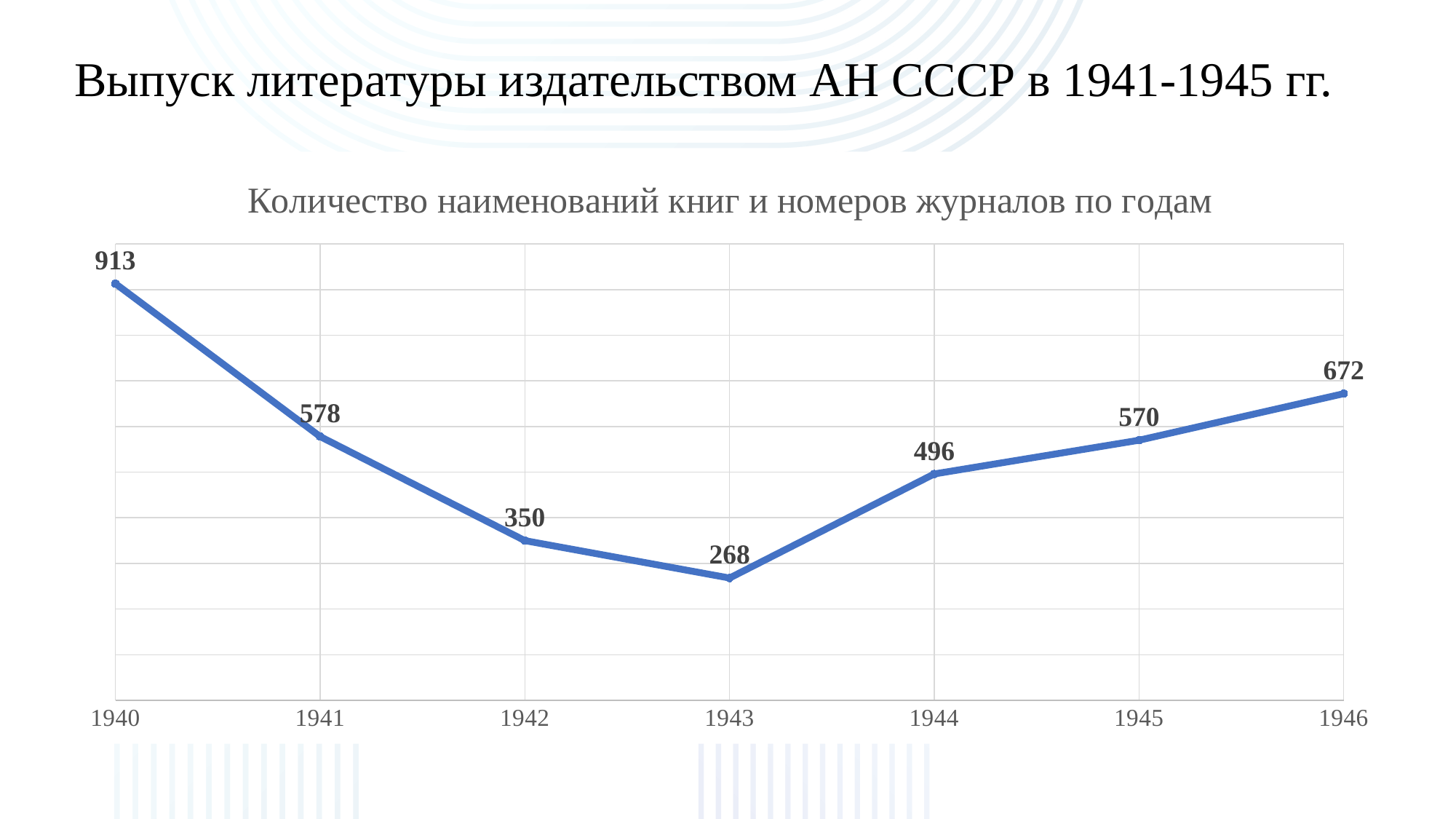
Do the values rise or fall from 1940 to 1943? Fall What kind of chart is shown? Line chart Which is larger, the value for 1941 or the value for 1945? 1941 What is the value for 1946? 672 Which year has the lowest value? 1943 What is the value for 1944? 496 How many years are plotted on the chart? 7 Which year has the highest value? 1940 What is the value for 1943? 268 What is the value for 1940? 913 What is the difference between the values for 1946 and 1945? 102 What is the difference between the values for 1940 and 1941? 335